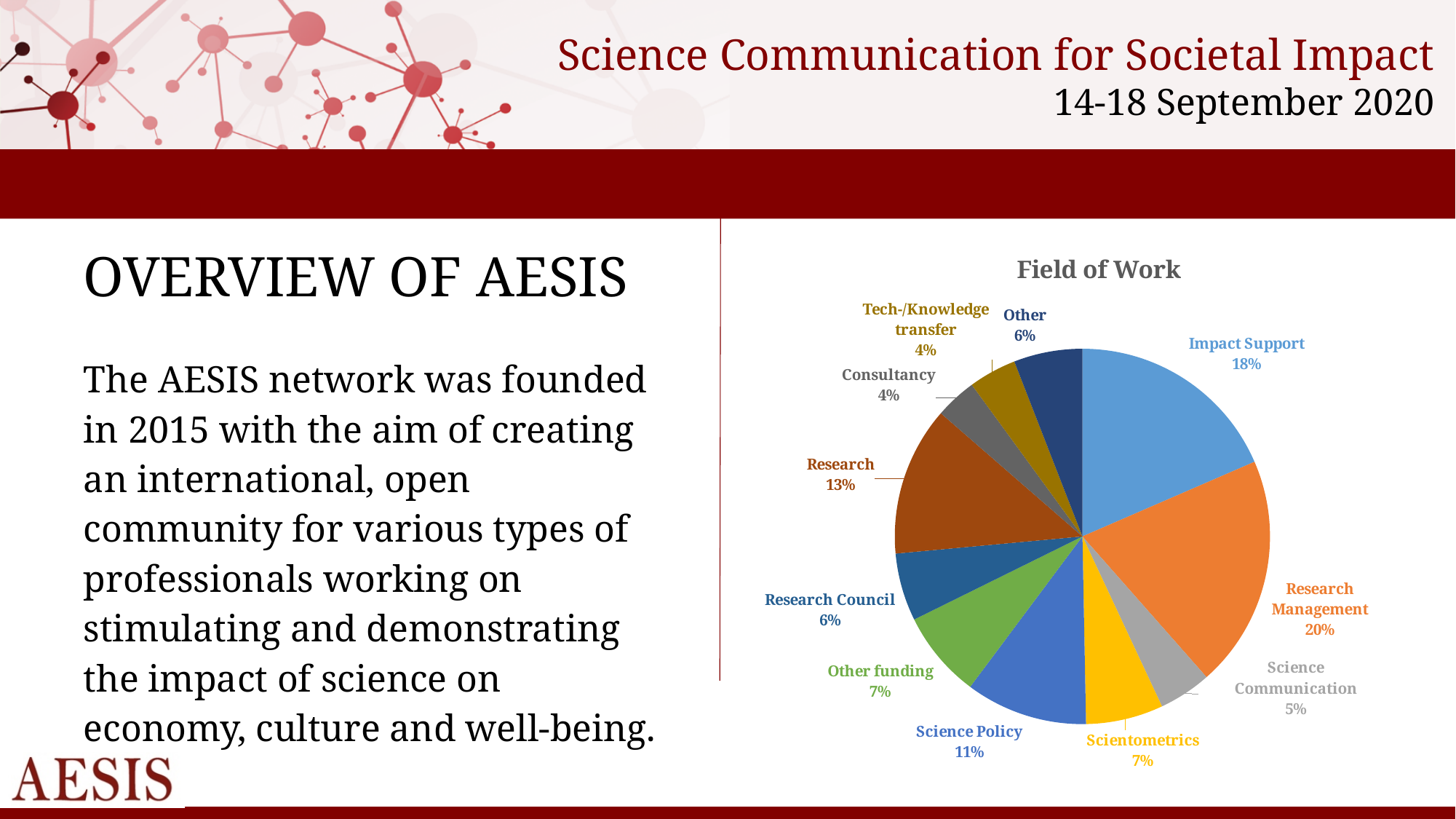
What is the title of the chart? Field of Work What percentage is shown for Science Policy? 11% Which field of work has the largest share of the pie? Research Management What share of the pie does Research Management represent? 20% How many categories are shown in the pie chart? 11 Which is larger, the share for Research or the share for Science Policy? Research What percentage is shown for Consultancy? 4% What percentage is shown for Impact Support? 18% What type of chart is shown on the slide? pie chart What percentage is shown for Science Communication? 5% What is the combined share of Scientometrics and Other funding? 14% What is the difference in percentage points between Research Management and Research? 7